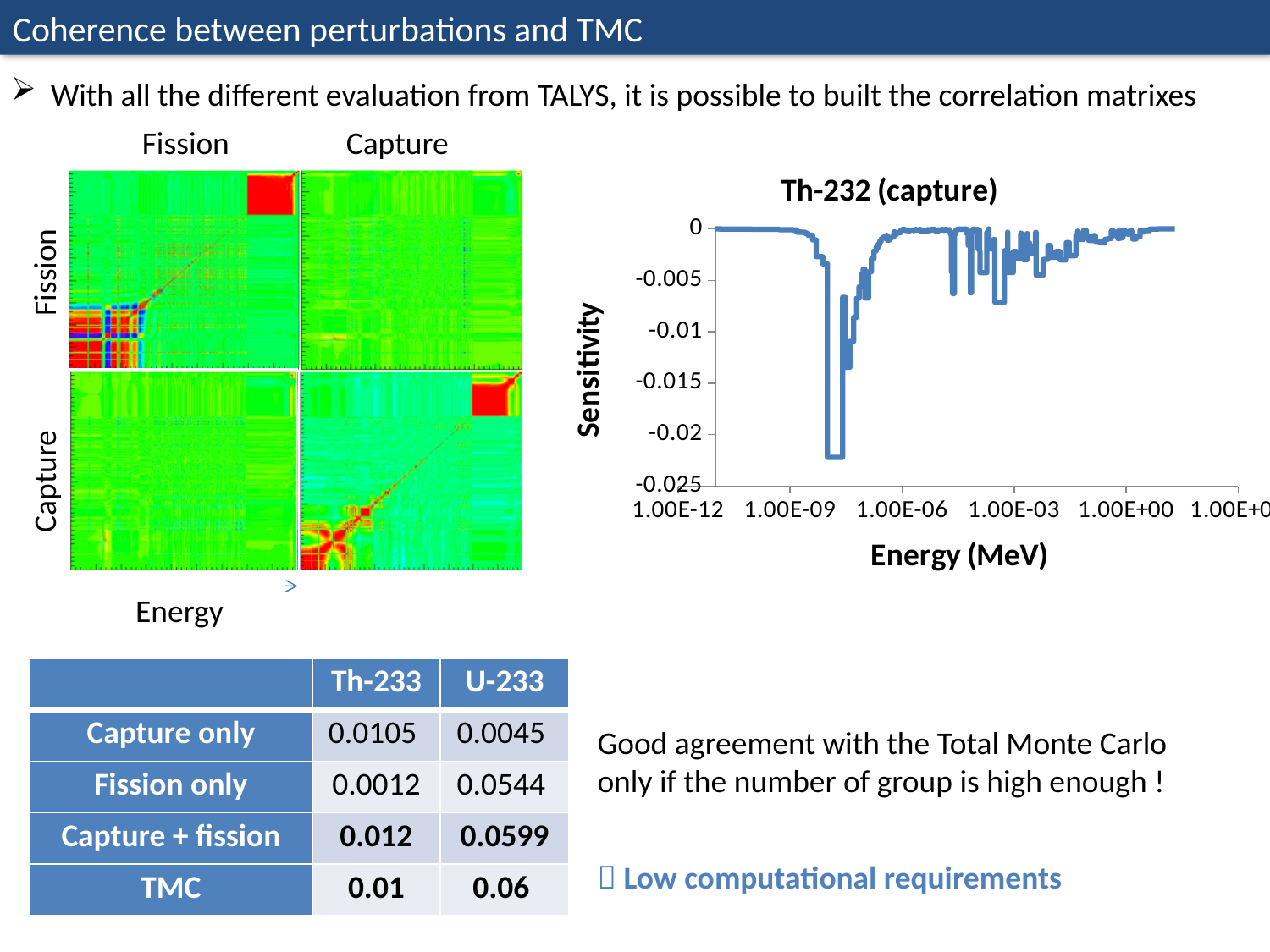
In the Th-232 (capture) chart, is the lowest sensitivity value greater or less than -0.02? less In the Th-232 (capture) chart, is the lowest sensitivity value greater or less than -0.025? greater In the Th-232 (capture) chart, between which two labelled x-axis ticks does the sensitivity reach its minimum? 1.00E-09 and 1.00E-06 In the Th-232 (capture) chart, does the sensitivity rise or fall as energy increases from the minimum point toward 1.00E-06 MeV? rise What kind of chart is the Th-232 (capture) chart? line chart In the Th-232 (capture) chart, is the sensitivity at 1.00E+00 MeV greater or less than -0.01? greater In the Th-232 (capture) chart, does the sensitivity rise or fall as energy increases from 1.00E-12 MeV to about 1.00E-08 MeV? fall What is the x-axis label of the Th-232 (capture) chart? Energy (MeV) What is the title of the line chart on the right of the slide? Th-232 (capture)